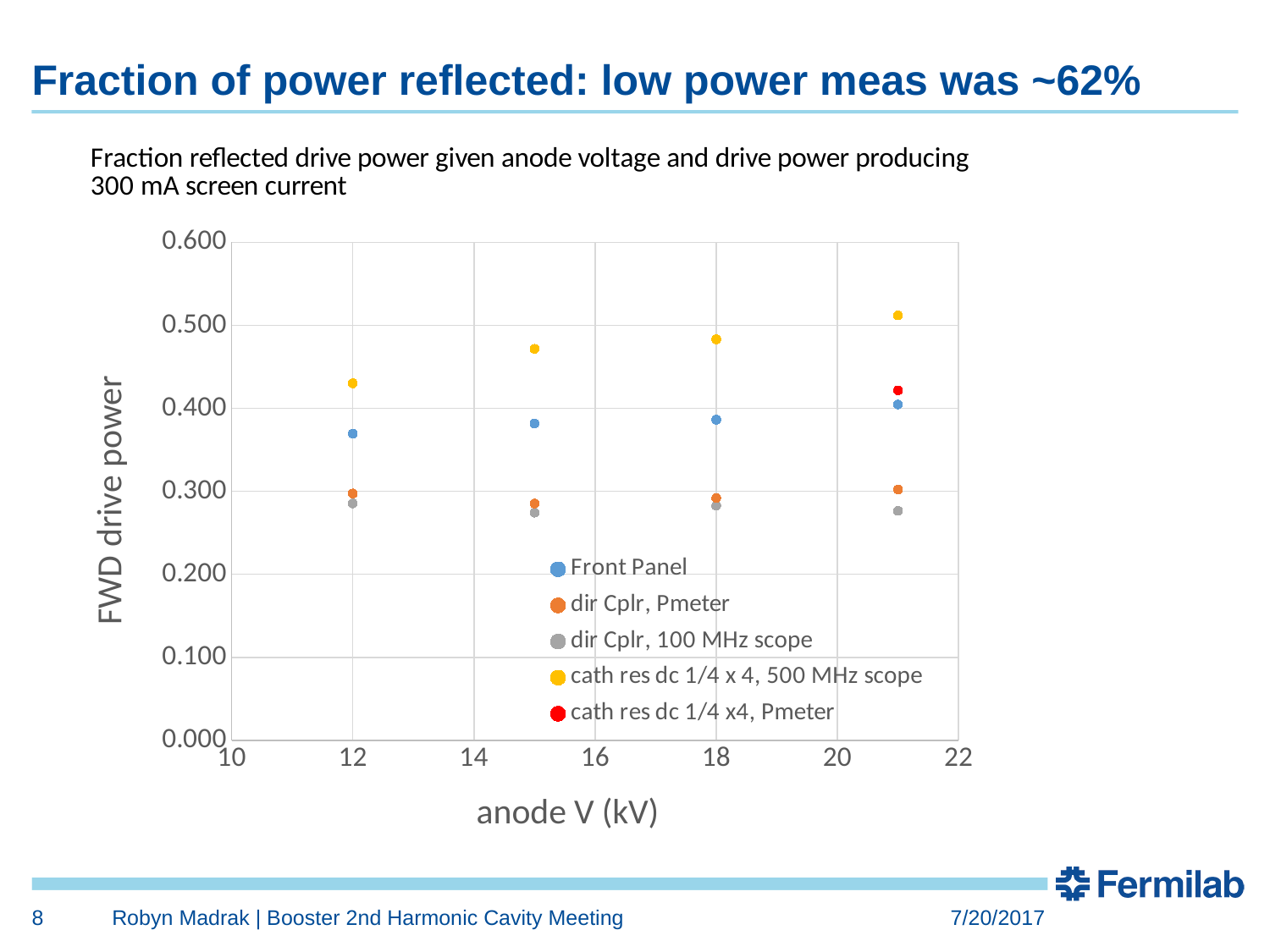
Do the values for 'cath res dc 1/4 x 4, 500 MHz scope' rise or fall as anode voltage increases? rise Is the value for Front Panel at 12 kV greater or less than 0.400? less Is the value for 'cath res dc 1/4 x 4, 500 MHz scope' at 12 kV greater or less than 0.400? greater How many data points are plotted for the Front Panel series? 4 How many data points are plotted for the 'cath res dc 1/4 x4, Pmeter' series? 1 Which series has the highest value at 21 kV? cath res dc 1/4 x 4, 500 MHz scope What kind of chart is shown on the slide? scatter chart What is the title of the x axis? anode V (kV) How many series does the legend list? 5 Is the value for 'cath res dc 1/4 x 4, 500 MHz scope' at 21 kV greater or less than 0.500? greater At 18 kV, which is larger: the Front Panel value or the 'dir Cplr, Pmeter' value? Front Panel Which series has the lowest value at 15 kV? dir Cplr, 100 MHz scope